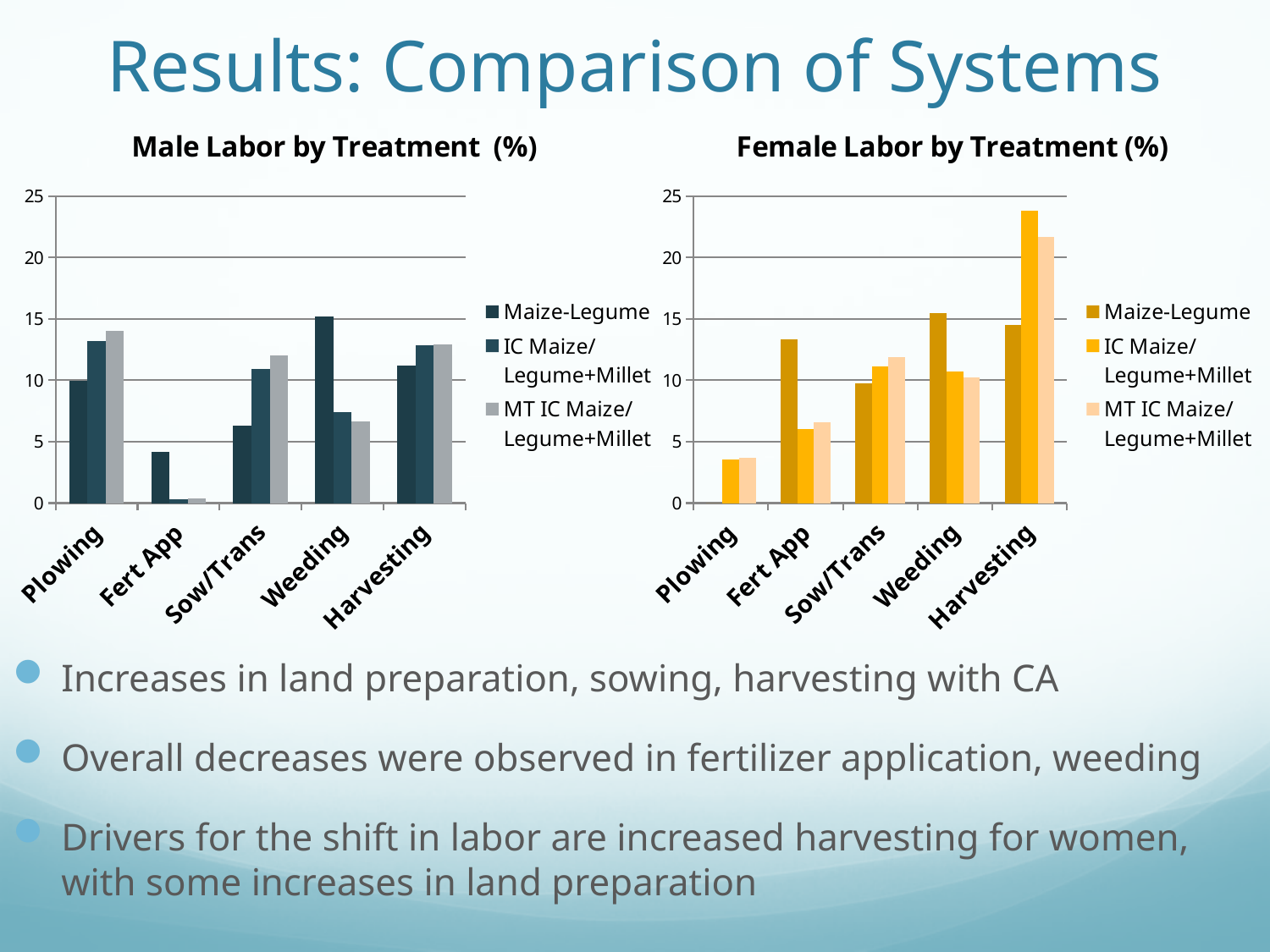
In the Male Labor by Treatment (%) chart, which category has the lowest IC Maize/Legume+Millet value? Fert App How many series does the legend of the Male Labor by Treatment (%) chart list? 3 In the Female Labor by Treatment (%) chart, is the IC Maize/Legume+Millet value for Harvesting greater or less than 20? greater In the Female Labor by Treatment (%) chart, which category has the lowest Maize-Legume value? Plowing In the Female Labor by Treatment (%) chart, for Fert App, which is larger: the Maize-Legume value or the IC Maize/Legume+Millet value? Maize-Legume What is the title of the chart on the right side of the slide? Female Labor by Treatment (%) What kind of chart is the Male Labor by Treatment (%) chart? bar chart In the Male Labor by Treatment (%) chart, is the Maize-Legume value for Weeding greater or less than 10? greater In the Male Labor by Treatment (%) chart, for Weeding, which is larger: the Maize-Legume value or the IC Maize/Legume+Millet value? Maize-Legume In the Female Labor by Treatment (%) chart, which category has the highest IC Maize/Legume+Millet value? Harvesting In the Male Labor by Treatment (%) chart, which category has the highest Maize-Legume value? Weeding How many categories are shown on the x axis of the Female Labor by Treatment (%) chart? 5